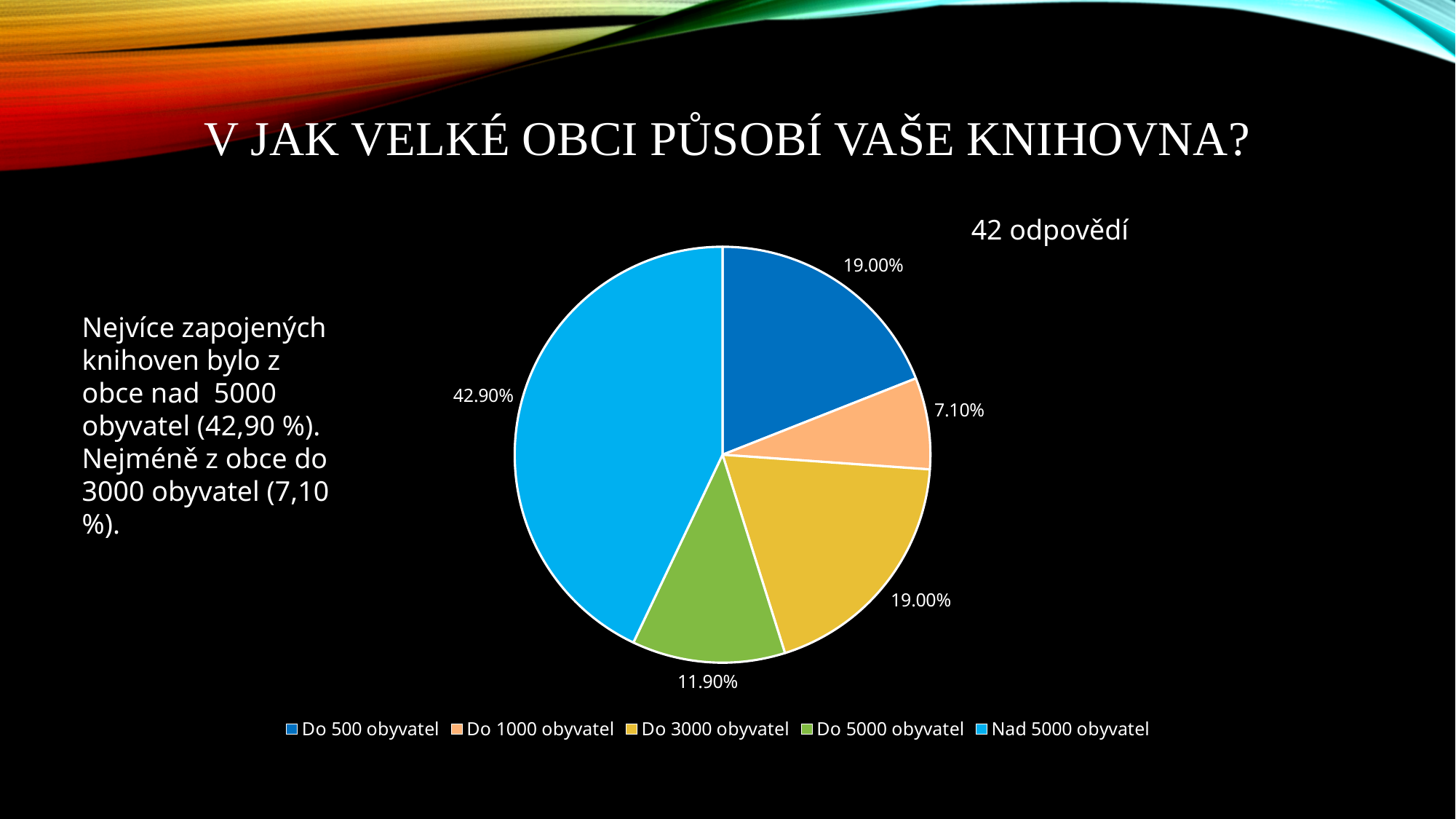
Which is larger, the slice for "Do 5000 obyvatel" or the slice for "Do 1000 obyvatel"? Do 5000 obyvatel Which category has the smallest slice of the pie? Do 1000 obyvatel How many categories does the pie chart show? 5 What is the difference in percentage points between "Nad 5000 obyvatel" and "Do 5000 obyvatel"? 31.00% What colour is the slice for "Do 3000 obyvatel"? yellow Which category has the largest slice of the pie? Nad 5000 obyvatel What kind of chart is shown on the slide? pie chart What share of the pie does "Nad 5000 obyvatel" have? 42.90% What share of the pie does "Do 500 obyvatel" have? 19.00% What share of the pie does "Do 5000 obyvatel" have? 11.90% How many responses does the slide say the chart is based on? 42 odpovědí What share of the pie does "Do 1000 obyvatel" have? 7.10%